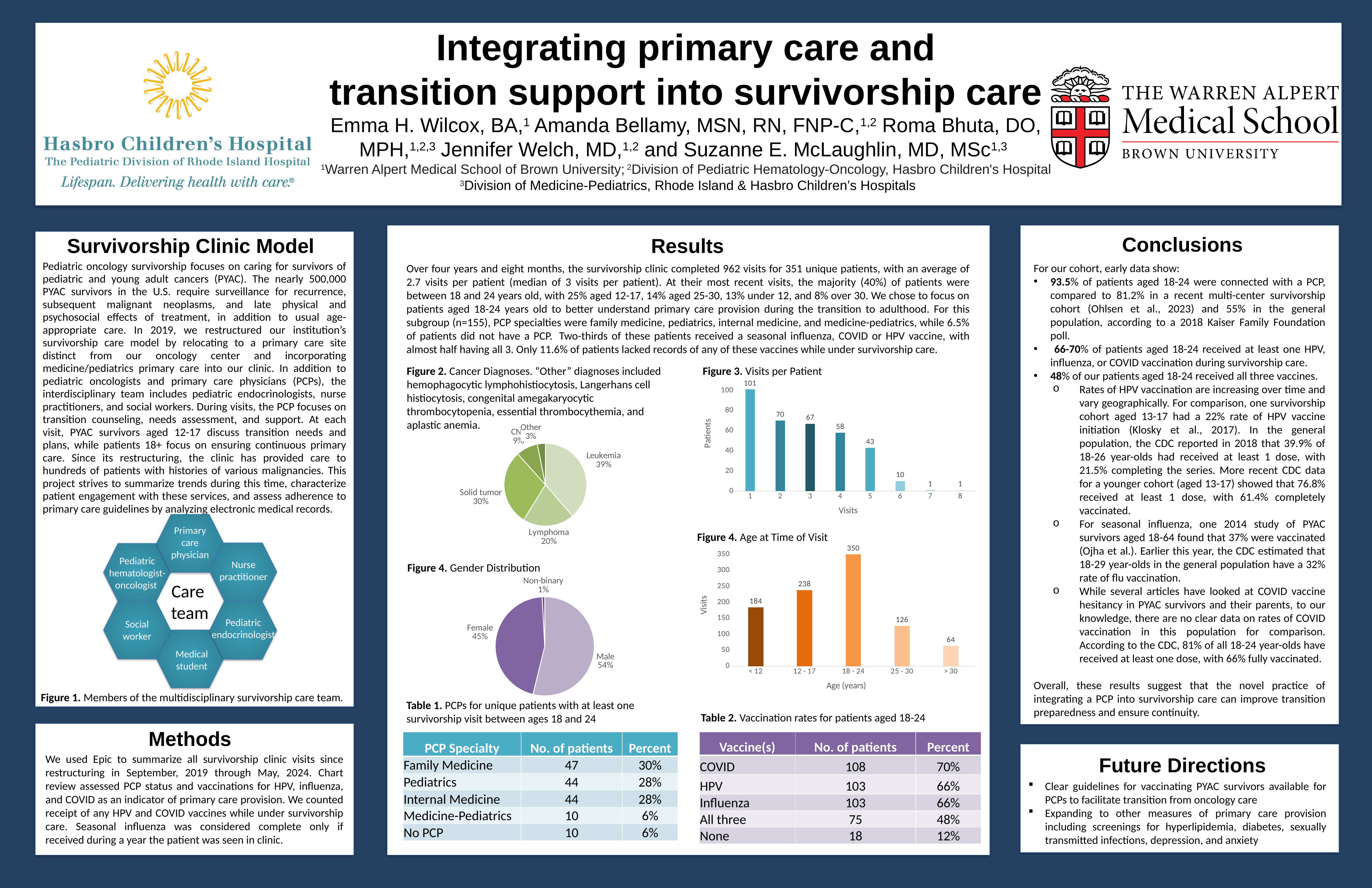
In the Visits per Patient chart (Figure 3), how many patients had 5 visits? 43 In the Age at Time of Visit chart (Figure 4), what is the difference in visits between the 18 - 24 group and the 25 - 30 group? 224 In the Age at Time of Visit chart (Figure 4), which age group has the most visits? 18 - 24 In the Visits per Patient chart (Figure 3), how many visit categories are shown on the x axis? 8 In the Age at Time of Visit chart (Figure 4), how many visits were for patients aged 12 - 17? 238 What type of chart is the Age at Time of Visit chart (Figure 4)? bar chart In the Visits per Patient chart (Figure 3), do the values generally rise or fall as the number of visits increases? fall In the Gender Distribution pie chart, what share of patients is Male? 54% In the Cancer Diagnoses pie chart (Figure 2), which diagnosis category has the largest slice? Leukemia In the Cancer Diagnoses pie chart (Figure 2), what is the difference in percentage points between Solid tumor and Lymphoma? 10 percentage points In the Visits per Patient chart (Figure 3), how many patients had exactly 1 visit? 101 In the Cancer Diagnoses pie chart (Figure 2), what share of diagnoses is Leukemia? 39%